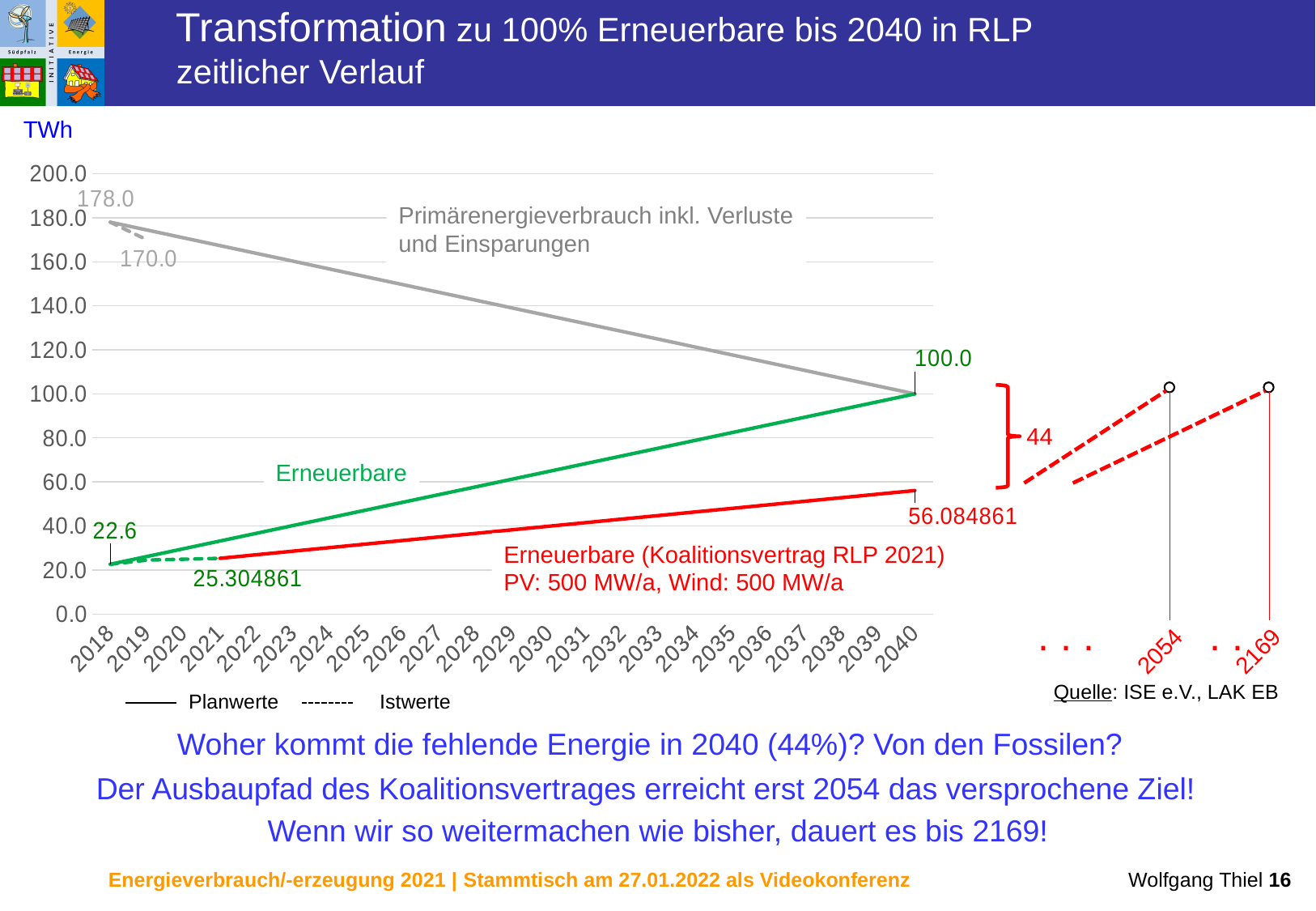
What two line styles does the legend distinguish? Planwerte (solid) and Istwerte (dashed) What is the value of the Erneuerbare (Koalitionsvertrag RLP 2021) line in 2021? 25.304861 What kind of chart is shown on the slide? line chart How many years are labelled on the x axis of the main chart (2018 to 2040)? 23 What value does the red Erneuerbare (Koalitionsvertrag RLP 2021) line reach in 2040? 56.084861 Is the value of the red Erneuerbare (Koalitionsvertrag RLP 2021) line in 2030 greater or less than 60.0? less What is the value of Primärenergieverbrauch inkl. Verluste und Einsparungen in 2018? 178.0 What is the value of Erneuerbare in 2018? 22.6 In 2040, which is larger: the green Erneuerbare line or the red Erneuerbare (Koalitionsvertrag RLP 2021) line? green Erneuerbare line What value does the green Erneuerbare line reach in 2040? 100.0 Does the Primärenergieverbrauch line rise or fall from 2018 to 2040? fall What is the difference between the Primärenergieverbrauch value in 2018 (178.0) and its value in 2040 (100.0)? 78.0